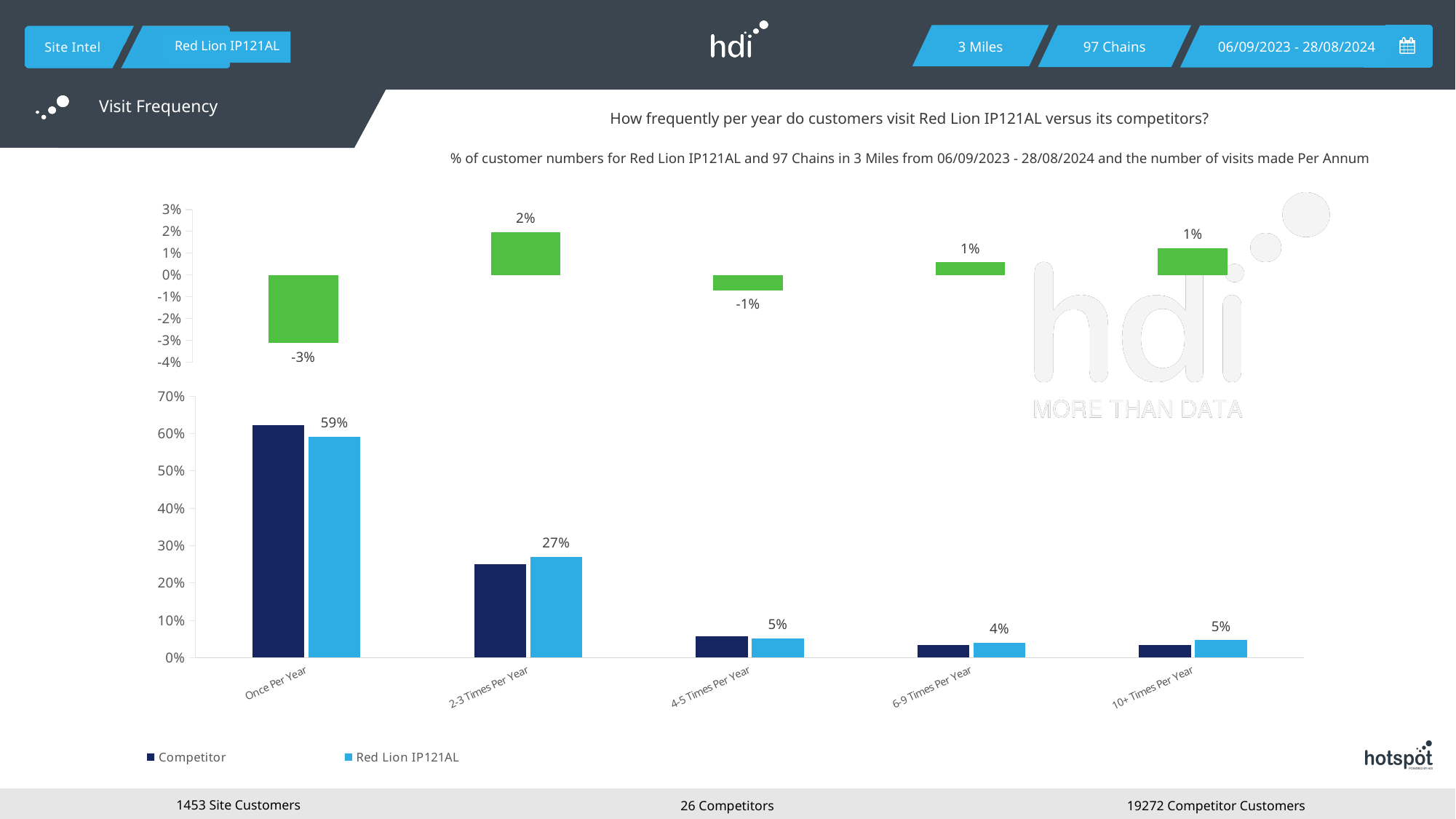
In the bottom chart, what is the difference between the Red Lion IP121AL values for Once Per Year and 2-3 Times Per Year? 32% In the bottom chart, what is the value for Red Lion IP121AL in the Once Per Year category? 59% How many series does the legend of the bottom chart list? 2 In the top chart, what is the value shown for Once Per Year? -3% In the bottom chart, is the Competitor value for Once Per Year greater or less than 60%? greater In the top chart, what is the value shown for 2-3 Times Per Year? 2% In the bottom chart, which category has the highest value for Red Lion IP121AL? Once Per Year In the bottom chart, what is the value for Red Lion IP121AL in the 2-3 Times Per Year category? 27% In the top chart, which category has the highest value? 2-3 Times Per Year In the top chart, which category has the lowest value? Once Per Year In the bottom chart, for Once Per Year, which series has the larger value: Competitor or Red Lion IP121AL? Competitor How many categories are shown on the x axis of the bottom chart? 5